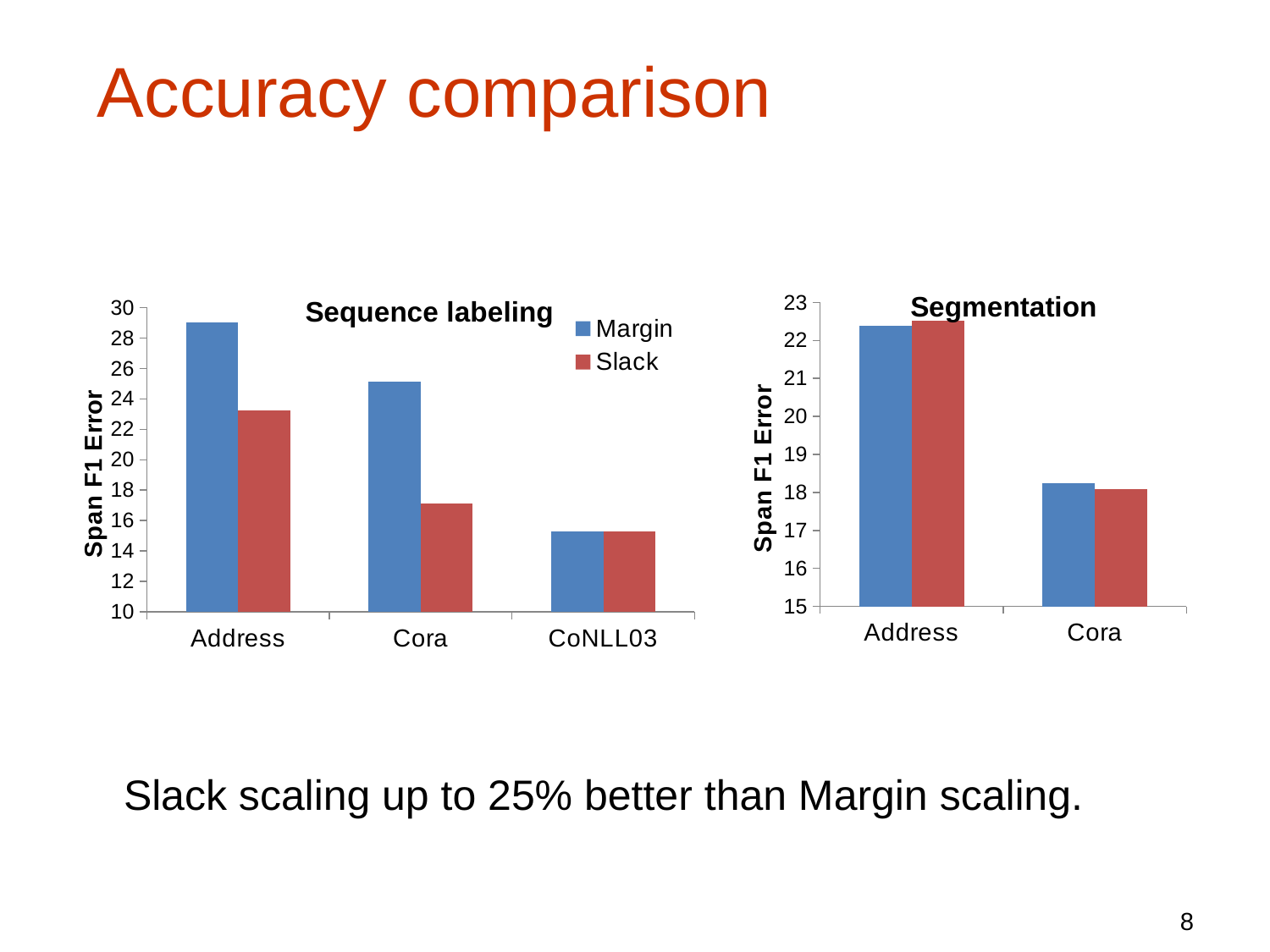
In the Segmentation chart, which category has the higher Slack value? Address In the Sequence labeling chart, which category has the highest Margin value? Address In the Sequence labeling chart, which category has the lowest Slack value? CoNLL03 How many categories are shown on the x axis of the Sequence labeling chart? 3 What kind of chart is the Sequence labeling chart? bar chart In the Sequence labeling chart, which is larger for Cora, the Margin value or the Slack value? Margin In the Sequence labeling chart, is the Margin value for Address greater or less than 28? greater In the Segmentation chart, is the Margin value for Cora greater or less than 19? less How many series does the legend of the Sequence labeling chart list? 2 What is the y-axis label of the Segmentation chart? Span F1 Error How many categories are shown on the x axis of the Segmentation chart? 2 In the Sequence labeling chart, is the Slack value for Cora greater or less than 18? less